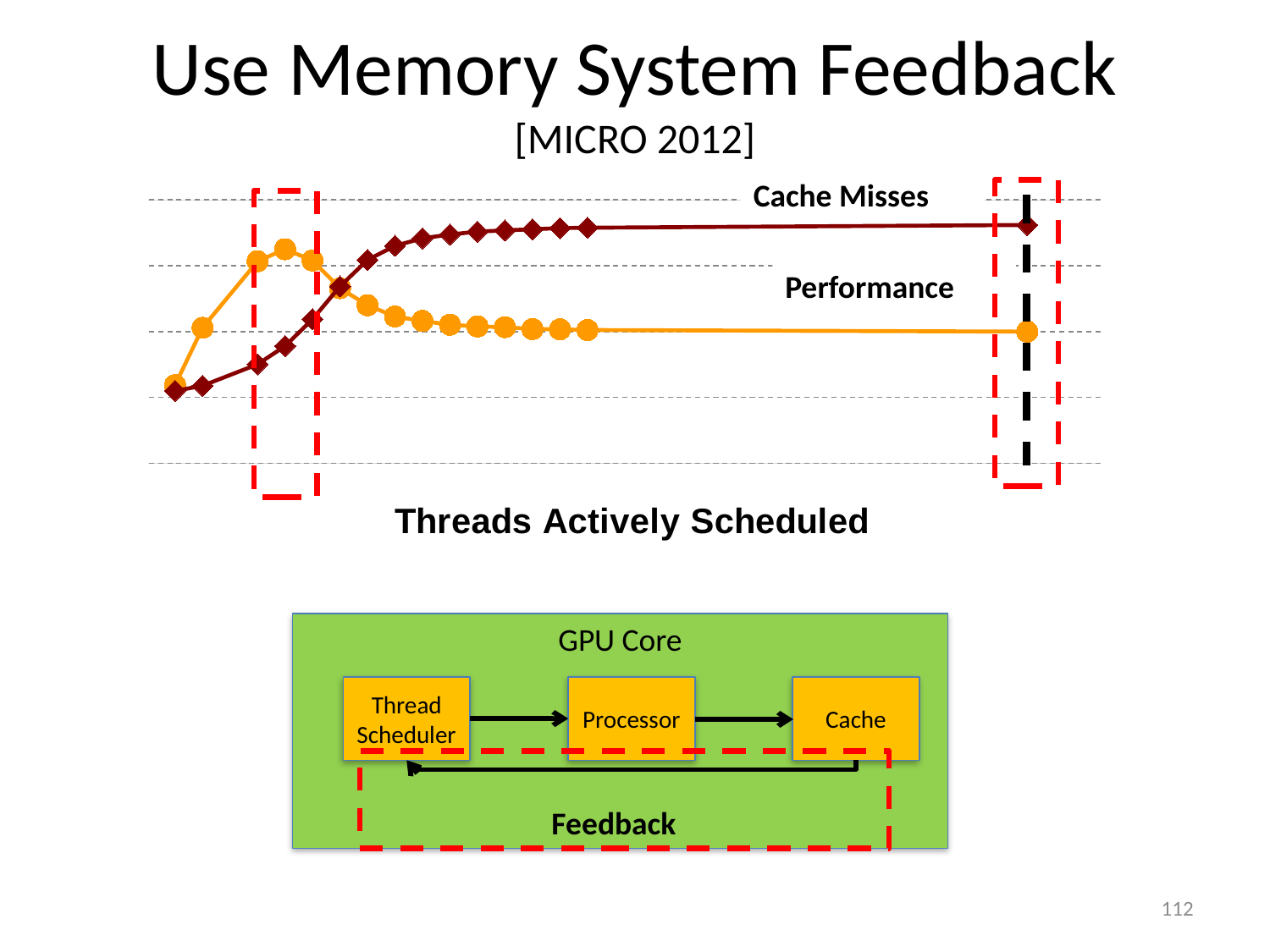
What kind of chart is shown on the slide? line chart How many data series are plotted on the chart? 2 What are the names of the two series plotted on the chart? Cache Misses and Performance Within the left red dashed box, where Performance peaks, which series is higher, Performance or Cache Misses? Performance At the far right of the chart (highest number of threads), which series has the higher value, Cache Misses or Performance? Cache Misses As the number of threads actively scheduled increases from the left, does the Cache Misses line initially rise or fall? rise After reaching its peak, does the Performance line rise or fall as more threads are actively scheduled? fall Which series reaches the highest point on the chart overall? Cache Misses What is the label of the x axis of the chart? Threads Actively Scheduled Does the Cache Misses line keep rising or level off toward the right side of the chart? level off